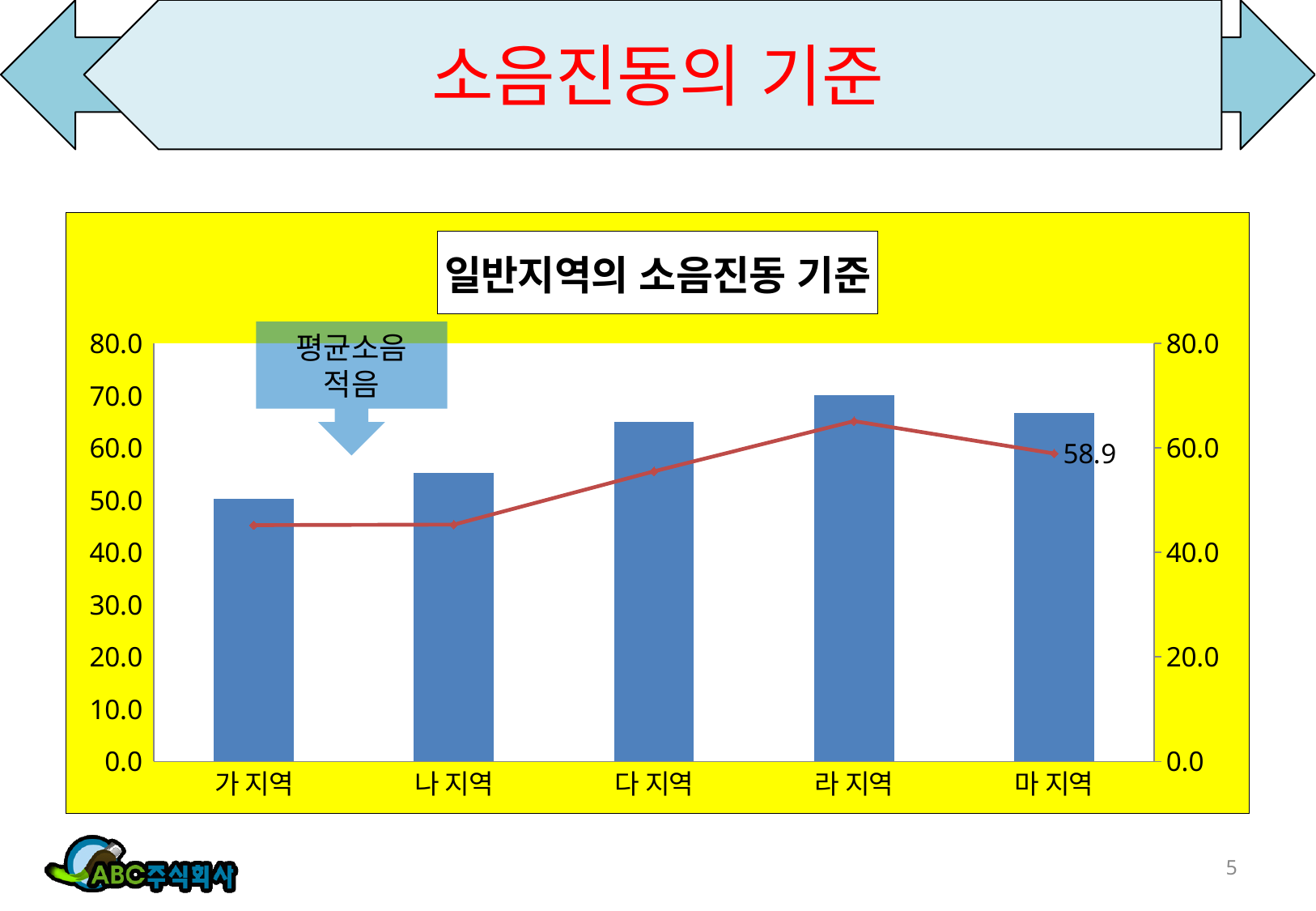
What text is in the callout box pointing at the 나 지역 bar? 평균소음 적음 Is the bar value for 나 지역 greater or less than 60.0? less What value is labelled on the line at 마 지역? 58.9 What kind of chart is shown on the slide? Bar chart with a line Which region has the shortest bar? 가 지역 Which region has the tallest bar? 라 지역 Which has the taller bar, 다 지역 or 나 지역? 다 지역 Does the red line rise or fall from 나 지역 to 라 지역? rises What is the title of the chart? 일반지역의 소음진동 기준 Is the bar value for 가 지역 greater or less than 60.0? less How many regions (categories) are shown on the x axis? 5 Is the bar value for 라 지역 greater or less than 60.0? greater